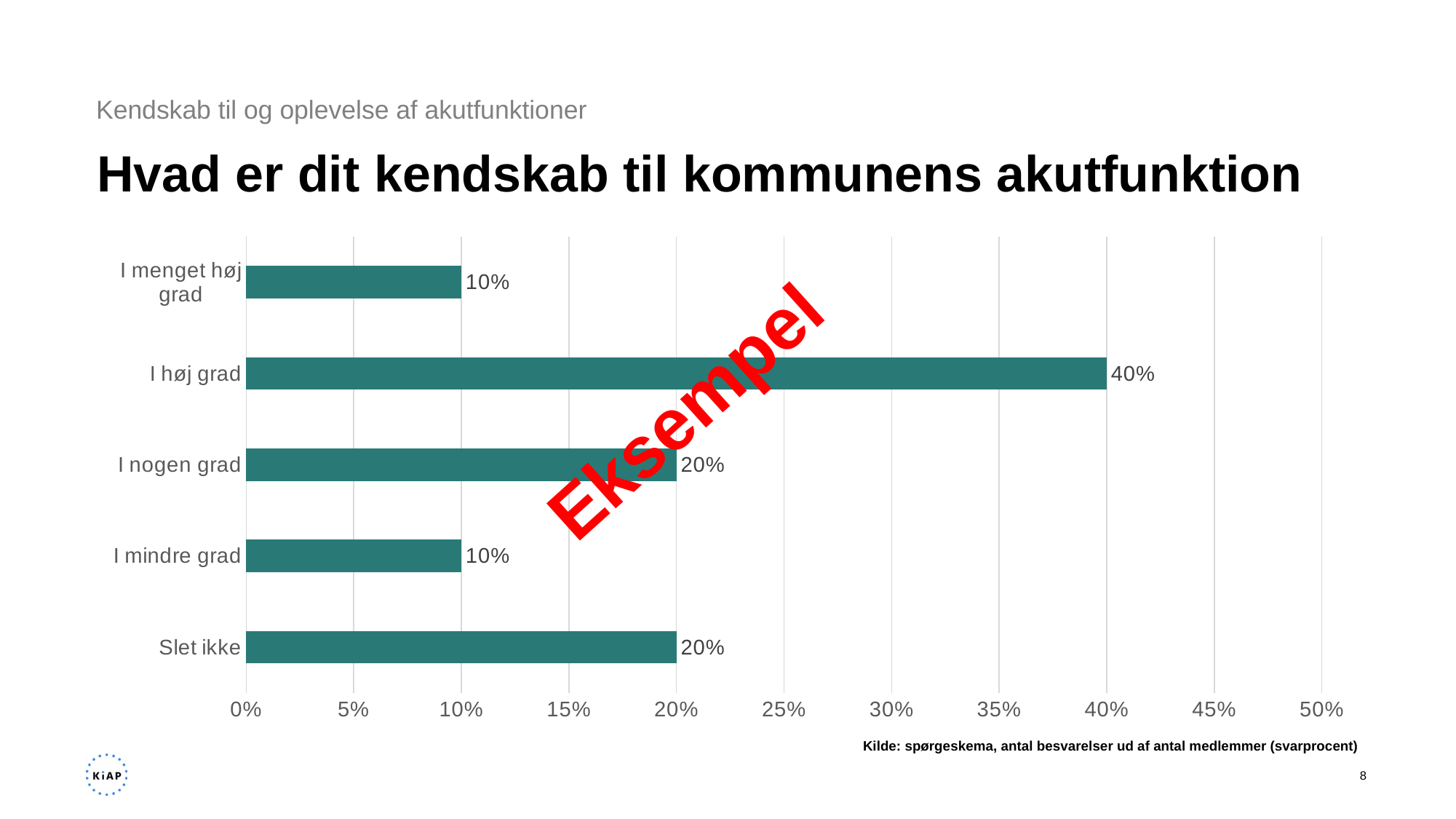
What is the value for "I nogen grad"? 20% What is the title of the chart on the slide? Hvad er dit kendskab til kommunens akutfunktion What is the value for "I høj grad"? 40% Which is larger, the value for "I høj grad" or the value for "Slet ikke"? I høj grad What is the value for "Slet ikke"? 20% How many categories are shown in the chart? 5 What is the difference between the values for "Slet ikke" and "I mindre grad"? 10% What is the value for "I mindre grad"? 10% What kind of chart is shown on the slide? bar chart Which category has the highest value? I høj grad Is the value for "I høj grad" greater or less than 30%? greater What is the difference between the values for "I høj grad" and "I nogen grad"? 20%